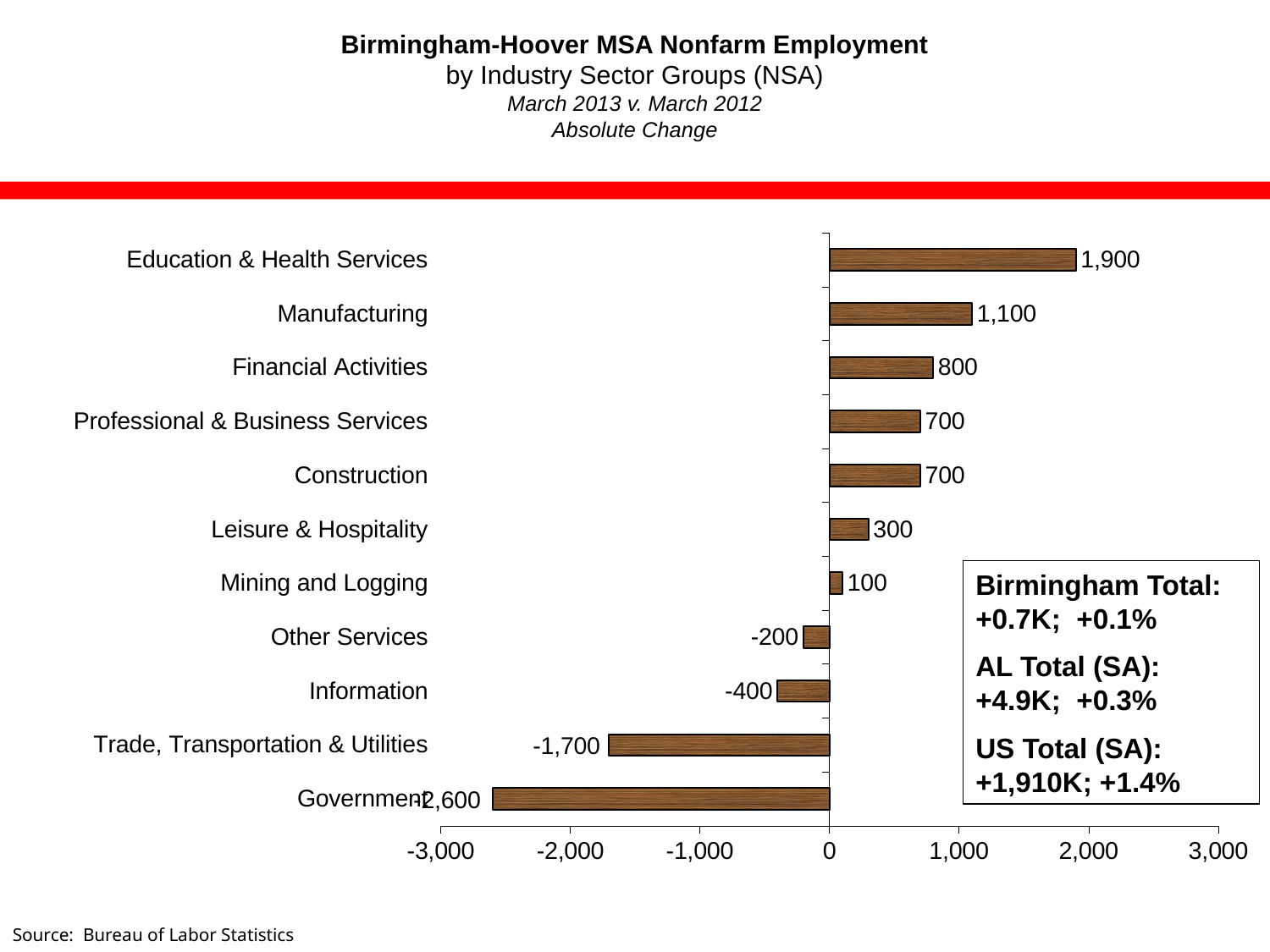
What is the value for Information? -400 Is the value for Government greater or less than -2,000? less What kind of chart is shown on the slide? bar chart What is the value for Trade, Transportation & Utilities? -1,700 What is the value for Education & Health Services? 1,900 What is the difference between the values for Education & Health Services and Manufacturing? 800 How many industry sector groups are shown in the chart? 11 Which industry sector has the lowest value? Government Which industry sector has the highest value? Education & Health Services Which is larger, the value for Financial Activities or the value for Leisure & Hospitality? Financial Activities What is the source cited for the chart? Bureau of Labor Statistics What is the value for Manufacturing? 1,100